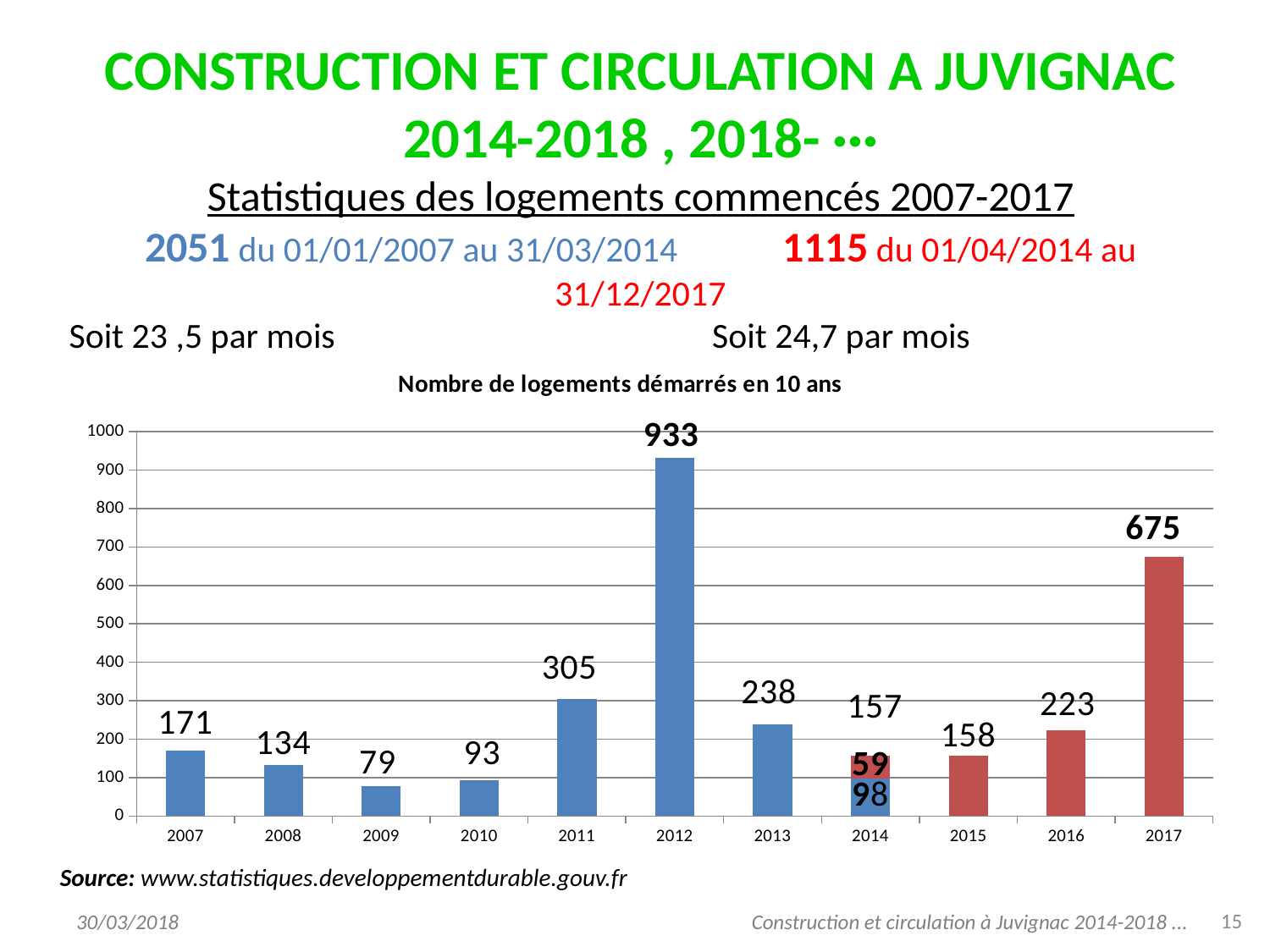
Which year has the lowest value? 2009 How many years are shown on the x axis of the chart? 11 What is the difference between the values for 2012 and 2017? 258 Do the values rise or fall from 2007 to 2009? fall What type of chart is shown on the slide? bar chart What is the value for 2012? 933 Which year has the highest value? 2012 What is the total of the stacked bar for 2014? 157 Which is larger, the value for 2011 or the value for 2013? 2011 What is the value for 2009? 79 What is the value for 2017? 675 What is the title of the chart? Nombre de logements démarrés en 10 ans